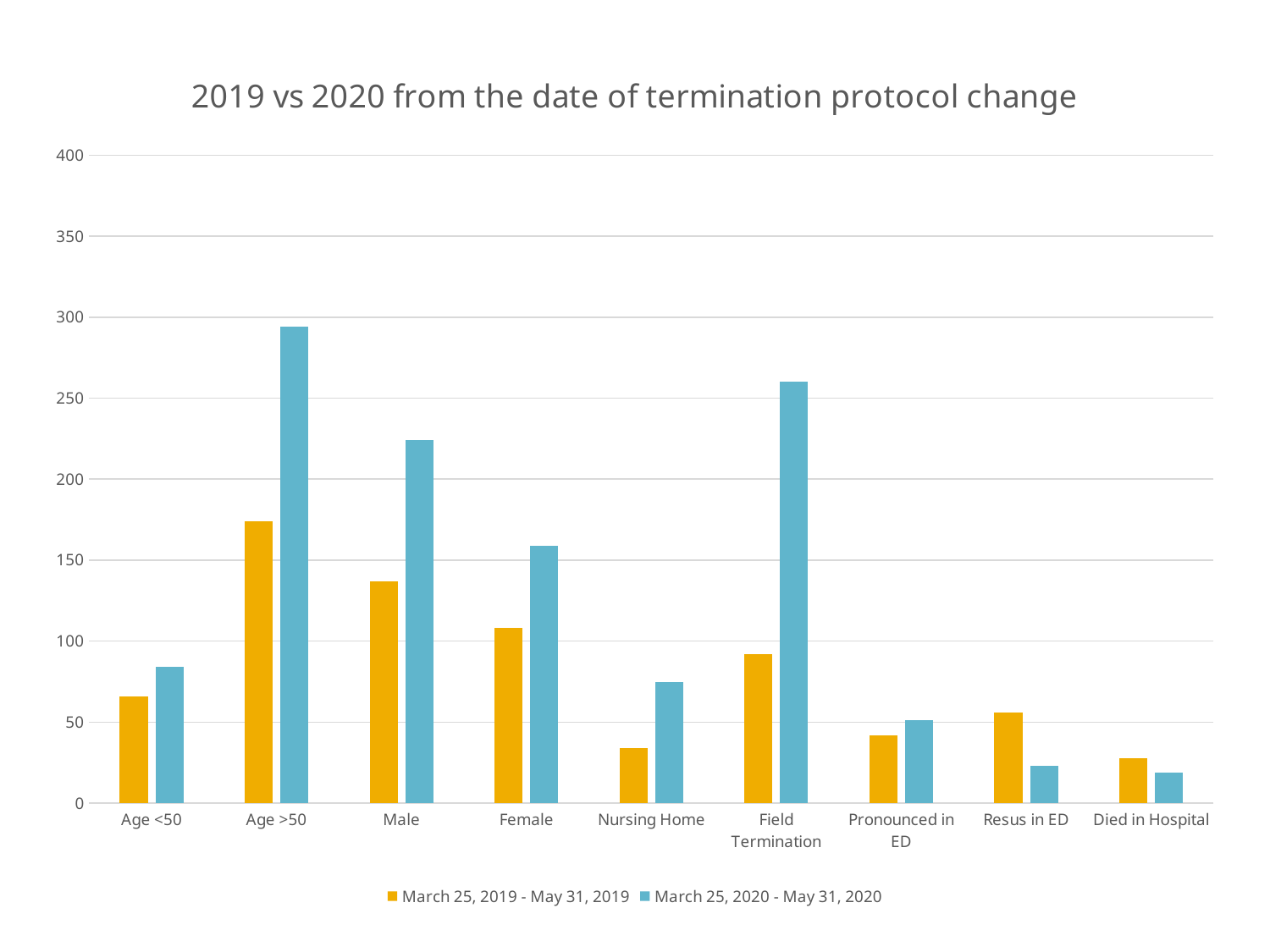
How many categories are shown on the x axis? 9 How many series does the legend list? 2 What is the title of the chart? 2019 vs 2020 from the date of termination protocol change Is the value for Age >50 in the March 25, 2020 - May 31, 2020 series greater or less than 250? greater For Field Termination, which series has the larger value: March 25, 2019 - May 31, 2019 or March 25, 2020 - May 31, 2020? March 25, 2020 - May 31, 2020 Which category has the highest value for the March 25, 2020 - May 31, 2020 series? Age >50 What kind of chart is shown on the slide? bar chart Which category has the lowest value for the March 25, 2019 - May 31, 2019 series? Died in Hospital Is the value for Male in the March 25, 2020 - May 31, 2020 series greater or less than 200? greater For Resus in ED, which series has the larger value: March 25, 2019 - May 31, 2019 or March 25, 2020 - May 31, 2020? March 25, 2019 - May 31, 2019 Is the value for Nursing Home in the March 25, 2019 - May 31, 2019 series greater or less than 50? less Which category has the highest value for the March 25, 2019 - May 31, 2019 series? Age >50